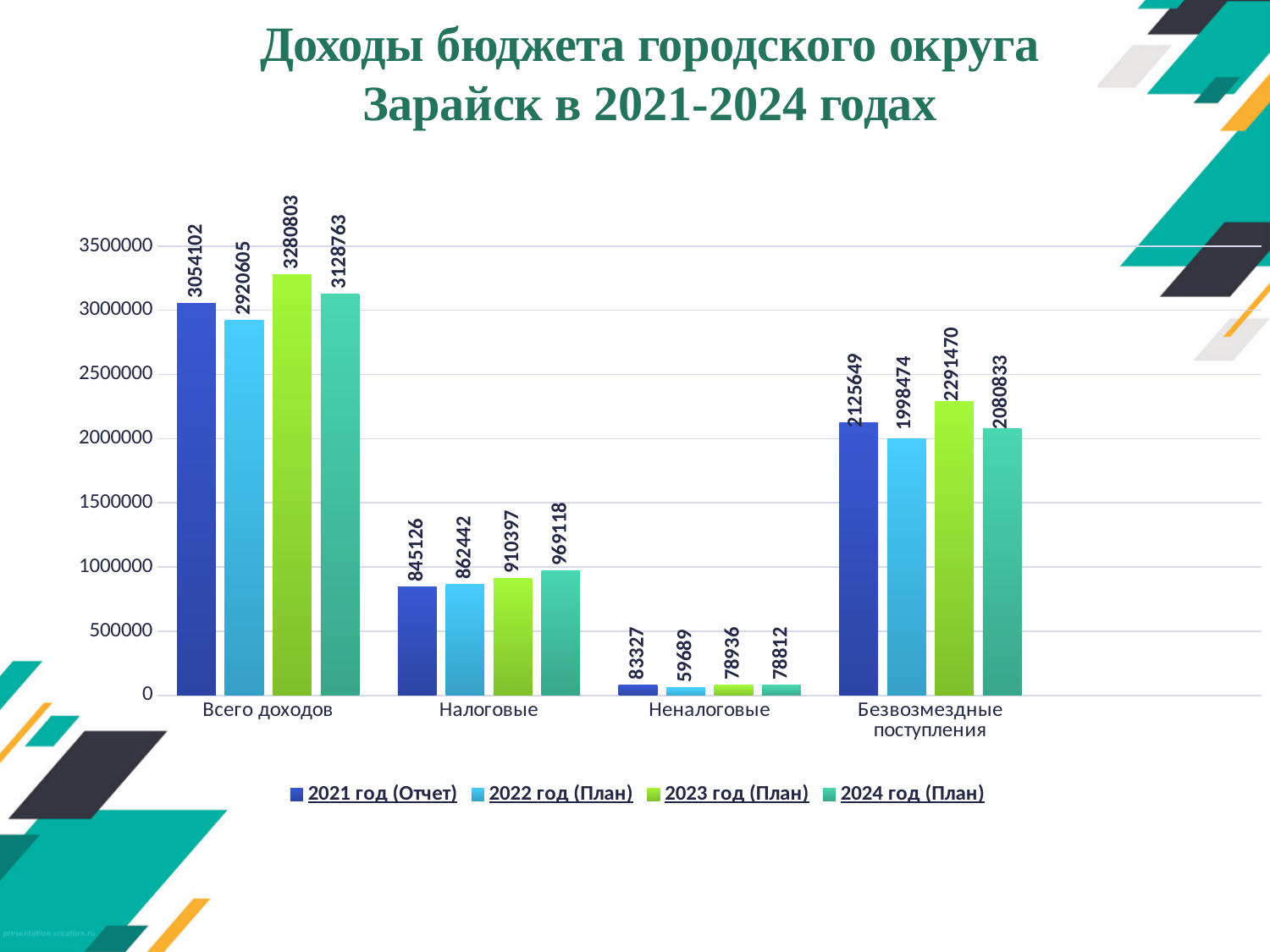
What is the value for Безвозмездные поступления in the 2023 год (План) series? 2291470 Which series has the highest value for Всего доходов? 2023 год (План) What is the difference between the 2024 год (План) and 2021 год (Отчет) values for Налоговые? 123992 What is the value for Всего доходов in the 2021 год (Отчет) series? 3054102 What is the value for Неналоговые in the 2022 год (План) series? 59689 What kind of chart is shown on the slide? Bar chart What is the value for Налоговые in the 2024 год (План) series? 969118 Which series has the lowest value for Неналоговые? 2022 год (План) Which is larger for Безвозмездные поступления: the 2021 год (Отчет) value or the 2024 год (План) value? 2021 год (Отчет) How many series does the legend list? 4 What is the difference between the 2023 год (План) and 2021 год (Отчет) values for Всего доходов? 226701 How many categories are shown on the x axis? 4